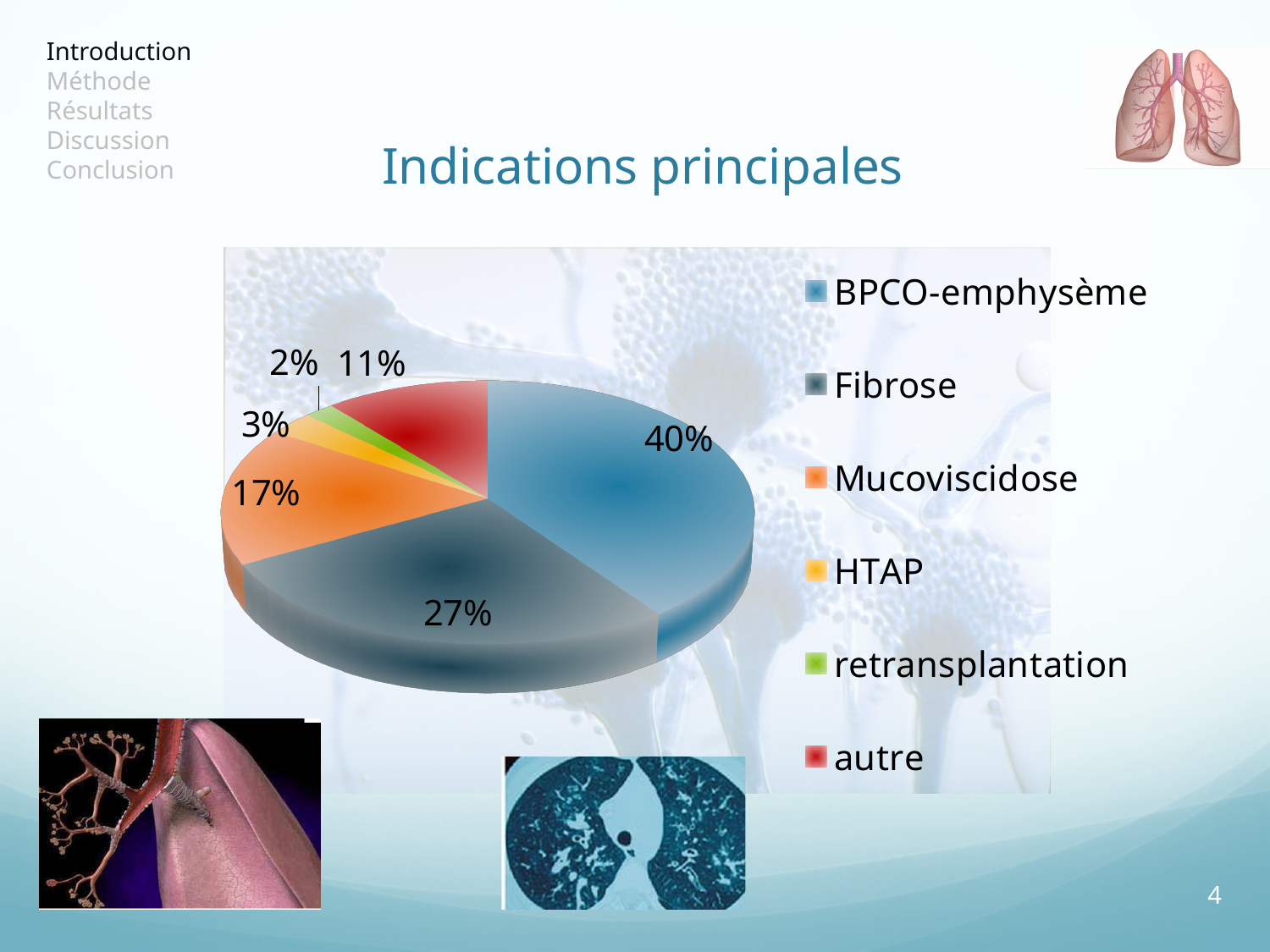
Which is larger, the share for Mucoviscidose or the share for autre? Mucoviscidose What is the difference in percentage points between BPCO-emphysème and Fibrose? 13 What share of the pie does Mucoviscidose represent? 17% What share of the pie does Fibrose represent? 27% What kind of chart is shown on the slide? pie chart Which category has the largest slice of the pie? BPCO-emphysème Which category has the smallest slice of the pie? retransplantation How many categories does the legend list? 6 What share of the pie does BPCO-emphysème represent? 40%